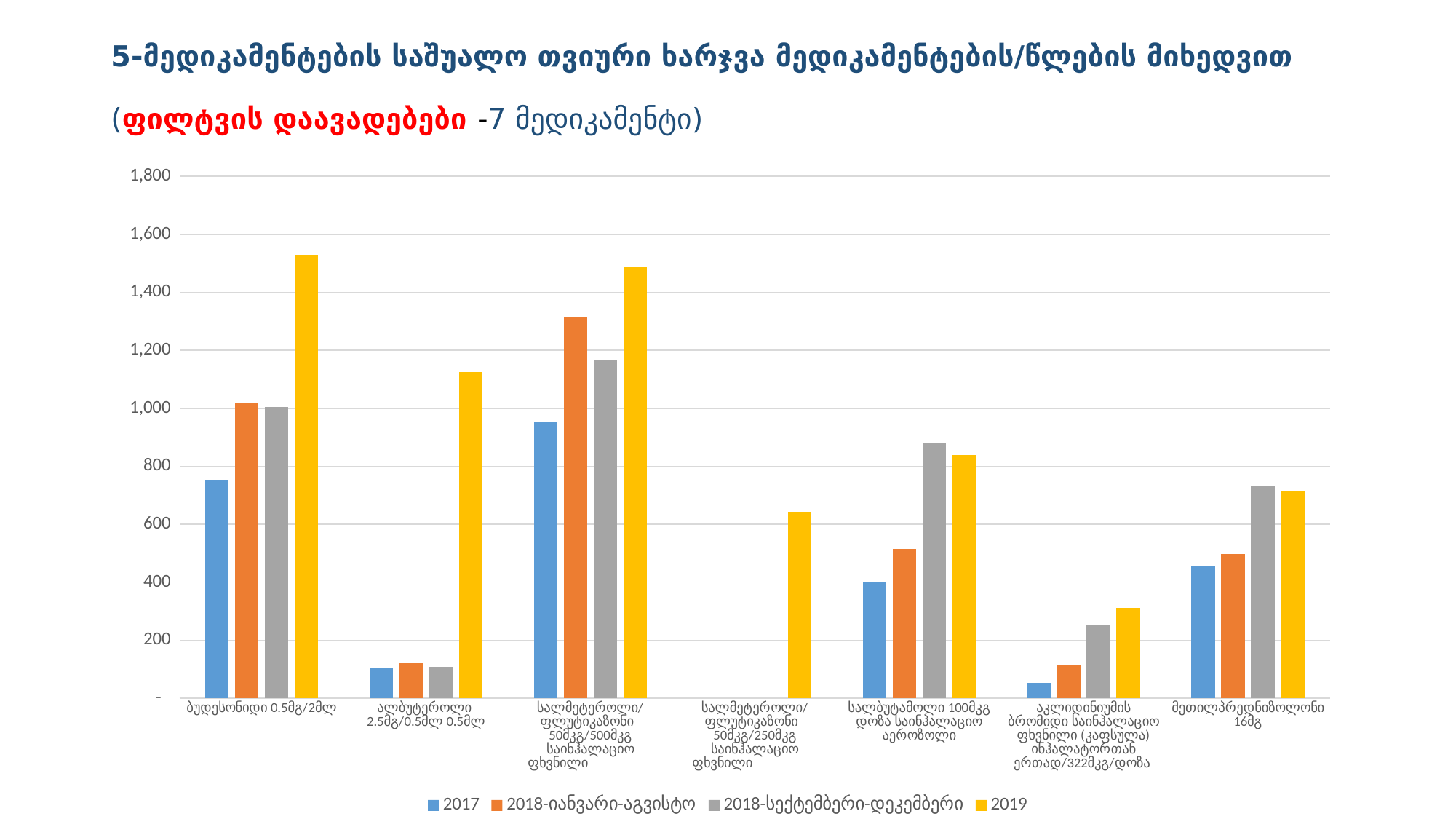
Is the 2019 value for ბუდესონიდი 0.5მგ/2მლ greater or less than 1,400? greater What kind of chart is shown on the slide? bar chart Which series has the lowest bar for აკლიდინიუმის ბრომიდი საინჰალაციო ფხვნილი (კაფსულა) ინჰალატორთან ერთად/322მკგ/დოზა? 2017 What colour are the bars for the 2019 series? yellow Is the 2017 value for ალბუტეროლი 2.5მგ/0.5მლ 0.5მლ greater or less than 200? less Which category has only a 2019 bar and no bars for the other series? სალმეტეროლი/ფლუტიკაზონი 50მკგ/250მკგ საინჰალაციო ფხვნილი How many series does the chart's legend list? 4 Do the values for აკლიდინიუმის ბრომიდი საინჰალაციო ფხვნილი (კაფსულა) ინჰალატორთან ერთად/322მკგ/დოზა rise or fall from the 2017 series to the 2019 series? rise Which series has the highest bar for ბუდესონიდი 0.5მგ/2მლ? 2019 Which is larger for 2017: the value for ბუდესონიდი 0.5მგ/2მლ or the value for სალმეტეროლი/ფლუტიკაზონი 50მკგ/500მკგ საინჰალაციო ფხვნილი? სალმეტეროლი/ფლუტიკაზონი 50მკგ/500მკგ საინჰალაციო ფხვნილი How many medication categories are shown on the x axis of the chart? 7 Is the 2019 value for სალმეტეროლი/ფლუტიკაზონი 50მკგ/250მკგ საინჰალაციო ფხვნილი greater or less than 600? greater